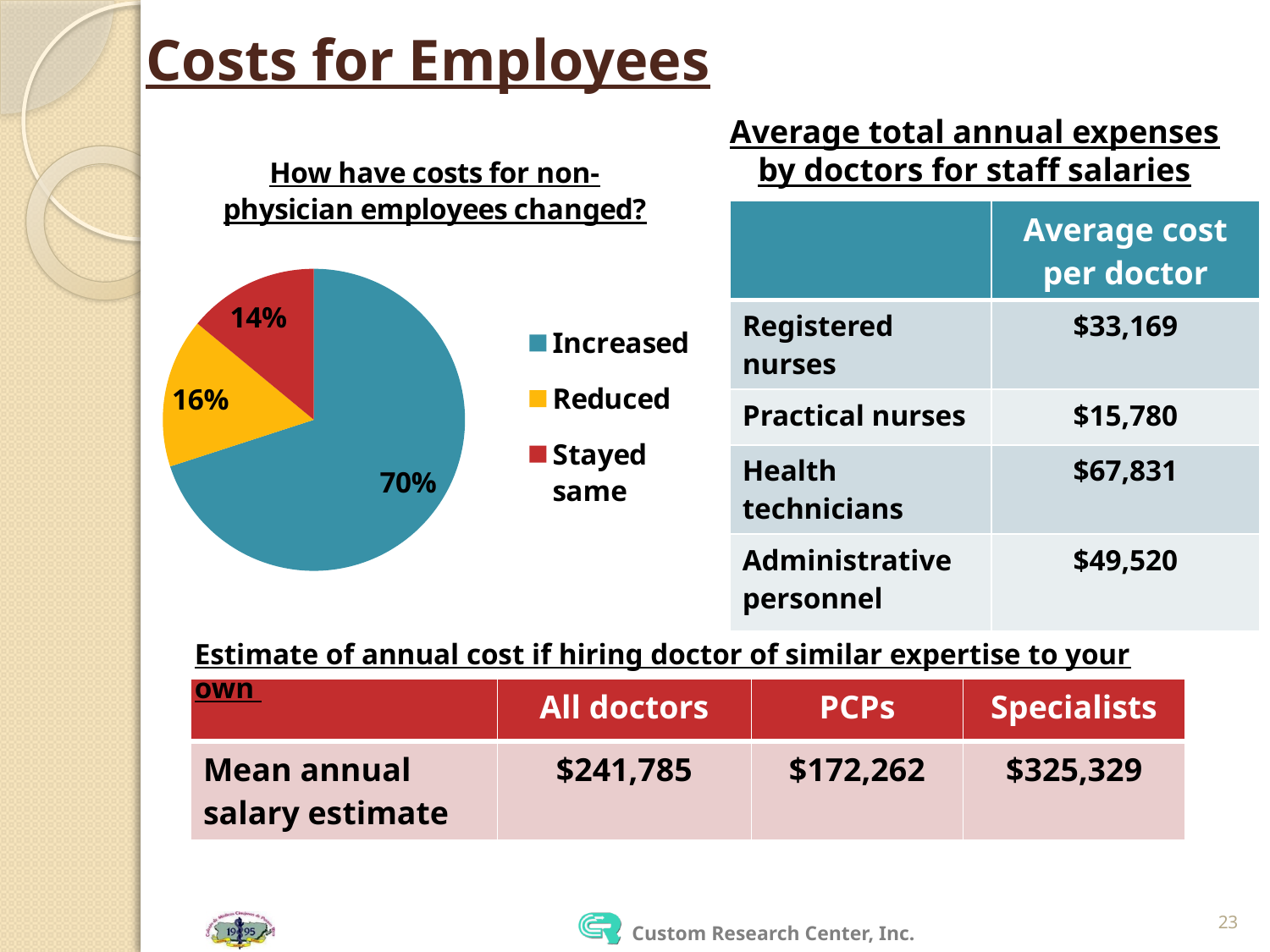
Which category has the largest slice in the pie chart? Increased What is the difference in percentage points between the "Reduced" and "Stayed same" slices? 2 What is the title of the pie chart? How have costs for non-physician employees changed? What share of the pie chart is labelled "Reduced"? 16% How many categories does the pie chart show? 3 Which category has the smallest slice in the pie chart? Stayed same What kind of chart is shown on the slide? pie chart What share of the pie chart is labelled "Stayed same"? 14% What colour is the "Increased" slice in the pie chart? blue What is the difference in percentage points between the "Increased" and "Reduced" slices? 54 What share of the pie chart is labelled "Increased"? 70% Which is larger in the pie chart, "Reduced" or "Stayed same"? Reduced